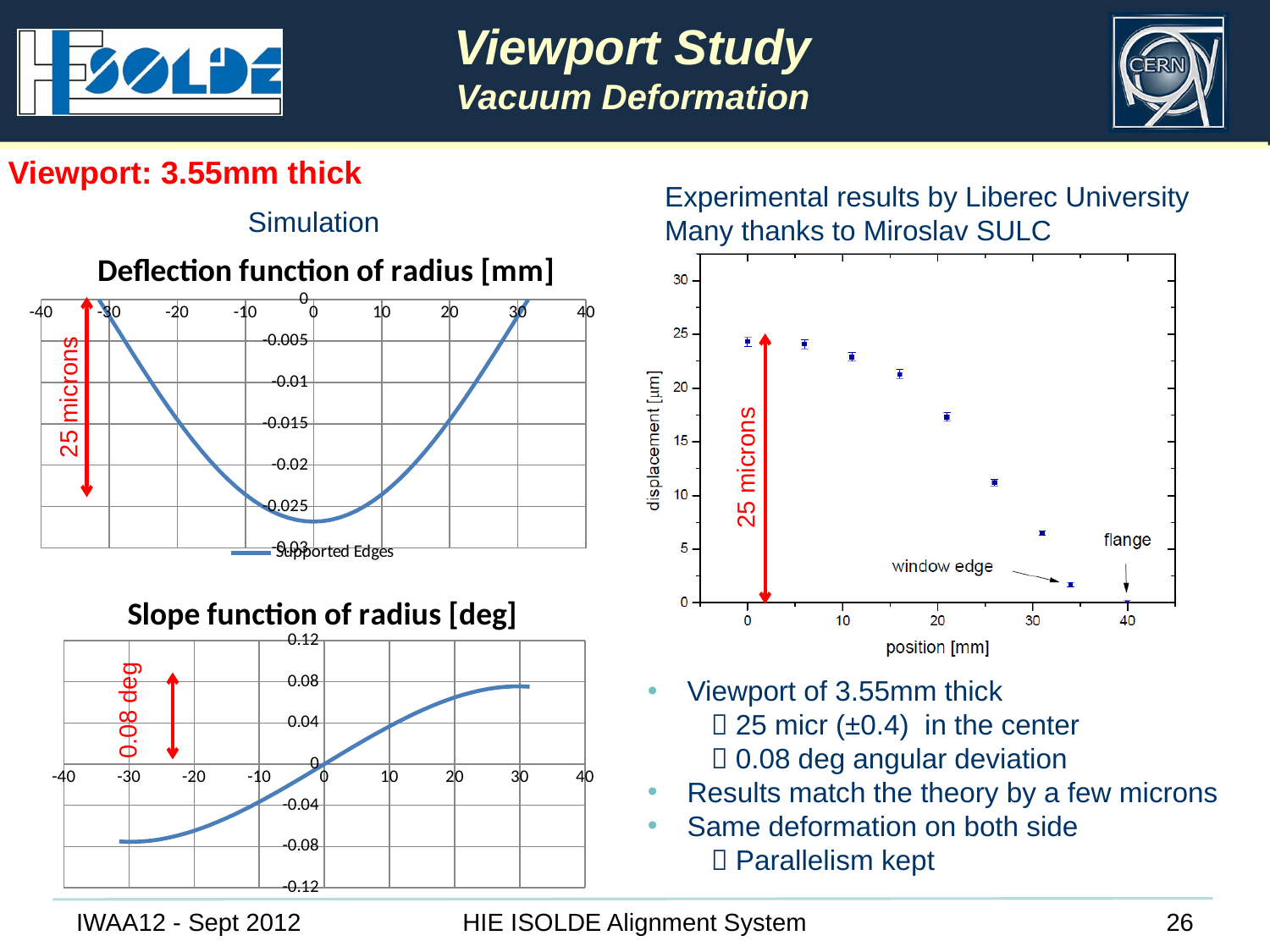
In the 'Deflection function of radius [mm]' chart, is the value at radius 0 greater or less than -0.02? less In the experimental displacement chart on the right, is the displacement at position 30 mm greater or less than 10? less In the experimental displacement chart on the right, do the displacement values rise or fall as position increases? fall What kind of chart is the 'Deflection function of radius [mm]' chart? line chart In the experimental displacement chart on the right, is the displacement at position 0 mm greater or less than 20? greater In the 'Deflection function of radius [mm]' chart, what is the legend entry for the plotted series? Supported Edges In the 'Slope function of radius [deg]' chart, do the values rise or fall as the radius increases from -40 to 40? rise In the 'Slope function of radius [deg]' chart, what is the slope value at radius 0? 0 In the experimental displacement chart on the right, what is the label of the y axis? displacement [µm] In the 'Deflection function of radius [mm]' chart, how many series does the legend list? 1